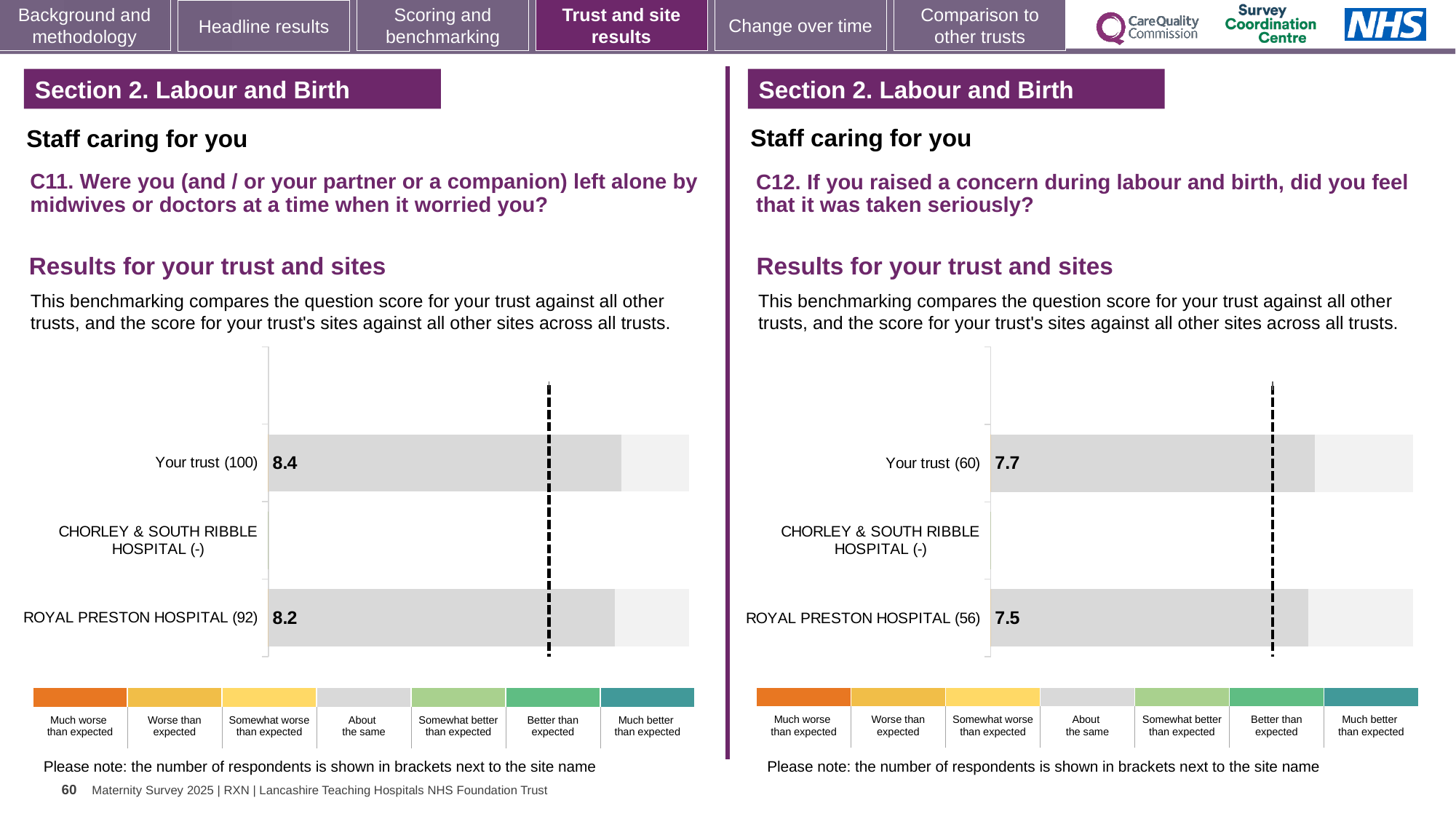
On the C12 chart (right), what is the score for Your trust? 7.7 On the C12 chart (right), which has the higher score, Your trust or ROYAL PRESTON HOSPITAL? Your trust On the C11 chart (left), what is the score for Your trust? 8.4 On the C12 chart (right), what is the difference between the Your trust score and the ROYAL PRESTON HOSPITAL score? 0.2 On the C12 chart (right), what is the score for ROYAL PRESTON HOSPITAL? 7.5 On the C11 chart (left), which category has no bar plotted? CHORLEY & SOUTH RIBBLE HOSPITAL (-) On the C11 chart (left), how many respondents are shown in brackets for Your trust? 100 On the C11 chart (left), what is the score for ROYAL PRESTON HOSPITAL? 8.2 On the C12 chart (right), how many respondents are shown in brackets for ROYAL PRESTON HOSPITAL? 56 On the C11 chart (left), what is the difference between the Your trust score and the ROYAL PRESTON HOSPITAL score? 0.2 What kind of chart is used on the C12 chart (right)? Bar chart How many site/trust categories are listed on the C11 chart (left)? 3